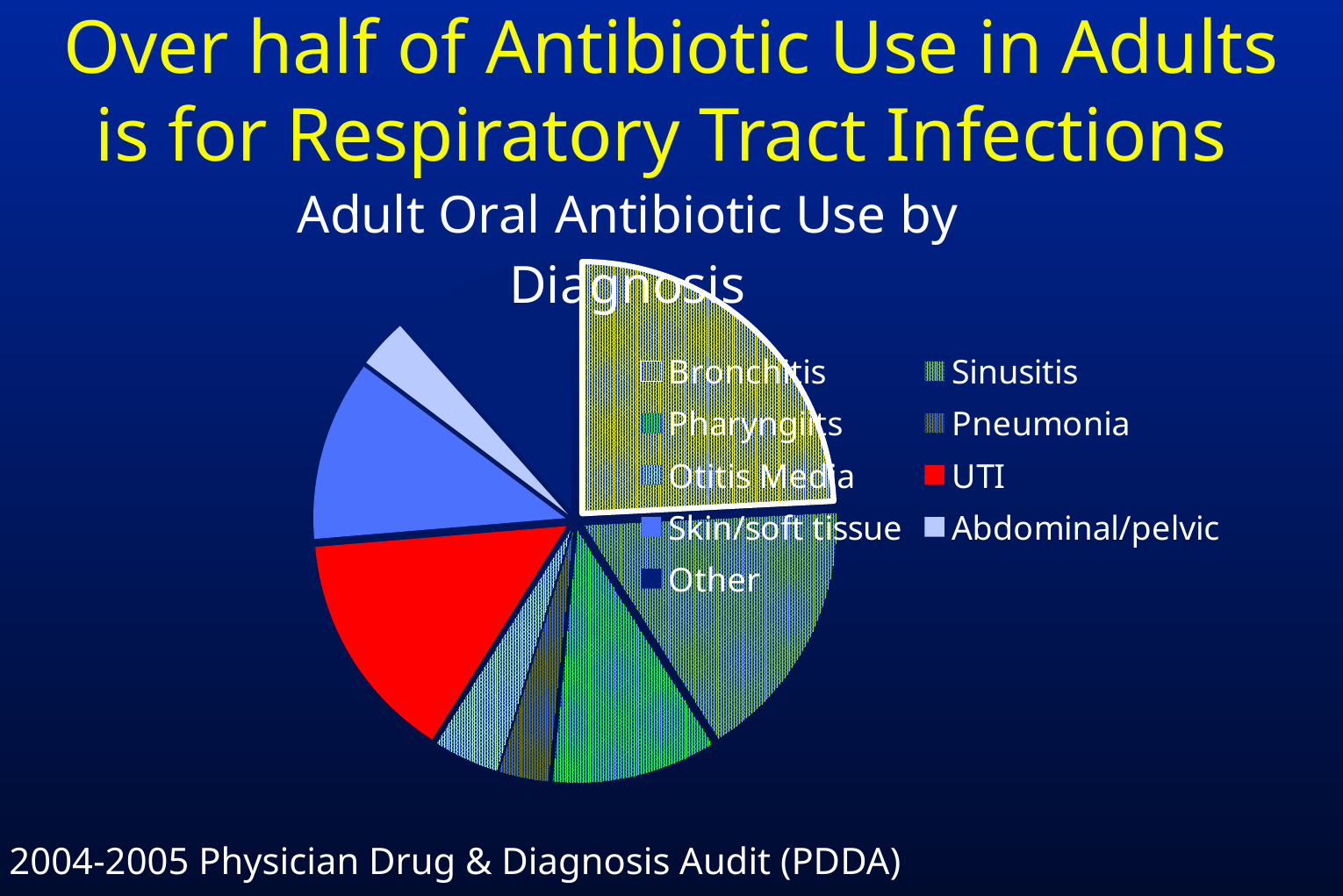
Which diagnosis is shown in red on the pie chart? UTI Which diagnosis has the largest slice of the pie chart? Bronchitis Which slice is larger, Bronchitis or Other? Bronchitis What kind of chart is shown on the slide? pie chart How many diagnosis categories does the pie chart's legend list? 9 Which slice is larger, Skin/soft tissue or Abdominal/pelvic? Skin/soft tissue Which slice is larger, Sinusitis or Other? Sinusitis What is the title of the pie chart? Adult Oral Antibiotic Use by Diagnosis